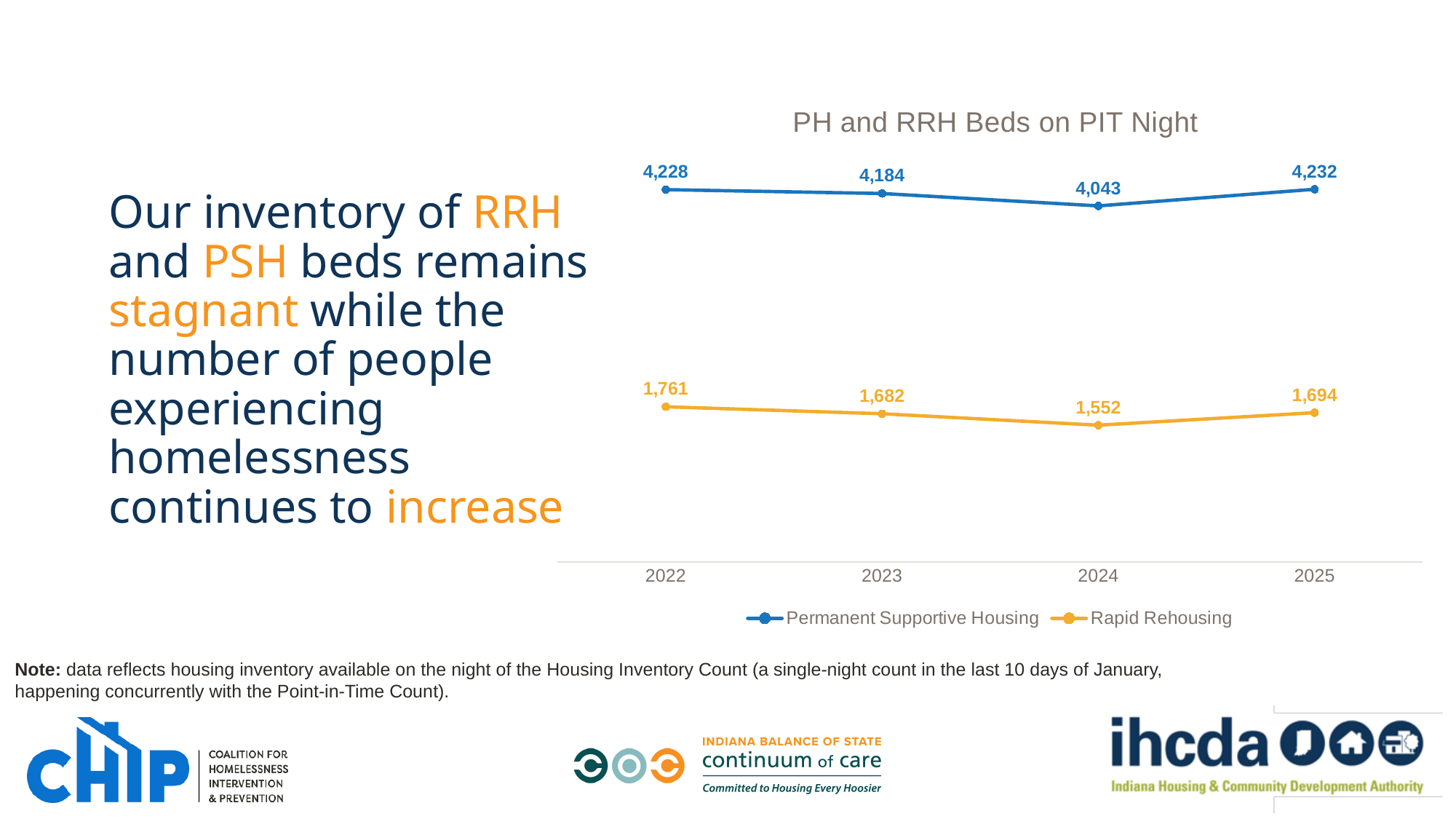
In which year is the Rapid Rehousing value highest? 2022 In which year is the Permanent Supportive Housing value lowest? 2024 What is the difference between the Permanent Supportive Housing values in 2025 and 2024? 189 What is the value for Rapid Rehousing in 2024? 1,552 What is the value for Permanent Supportive Housing in 2025? 4,232 What is the value for Rapid Rehousing in 2023? 1,682 Which is larger: Rapid Rehousing in 2023 or Rapid Rehousing in 2025? Rapid Rehousing in 2025 What is the difference between the Rapid Rehousing values in 2022 and 2025? 67 What kind of chart is shown? Line chart How many years are shown on the x axis? 4 What is the value for Permanent Supportive Housing in 2022? 4,228 How many series does the legend list? 2